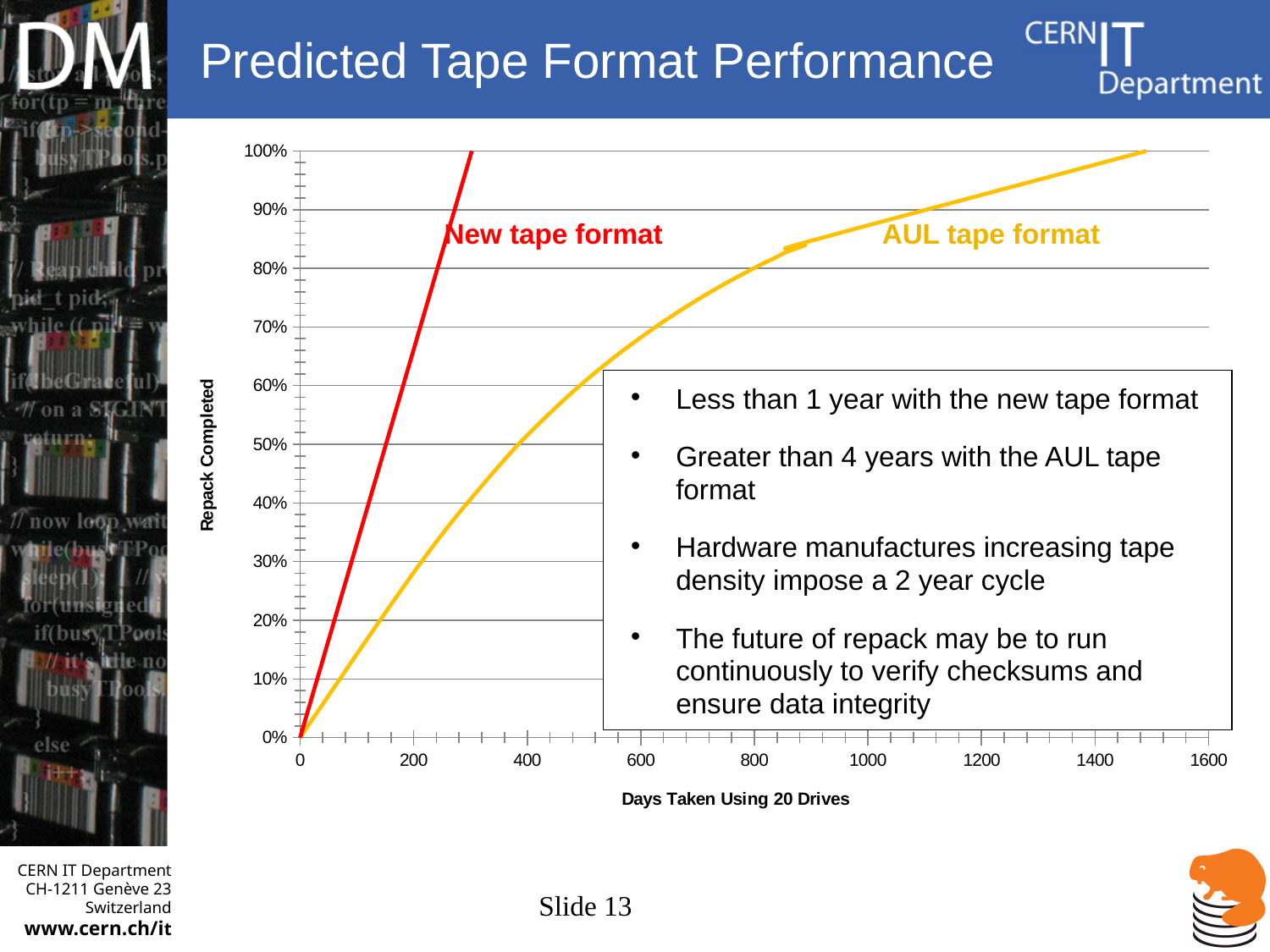
Which series is drawn in red on the chart? New tape format Is the number of days at which the New tape format reaches 100% repack completed greater or less than 400? less What is the title of the chart on the slide? Predicted Tape Format Performance Is the number of days at which the AUL tape format reaches 100% repack completed greater or less than 1400? greater At 200 days, is the Repack Completed value for the New tape format greater or less than 50%? greater What is the label of the x axis of the chart? Days Taken Using 20 Drives Which series takes more days to reach 100% repack completed? AUL tape format How many data series are plotted on the chart? 2 What kind of chart is shown on the slide? line chart Does the Repack Completed value for the AUL tape format rise or fall as the number of days increases? rise At 200 days, which series has the higher Repack Completed value, New tape format or AUL tape format? New tape format